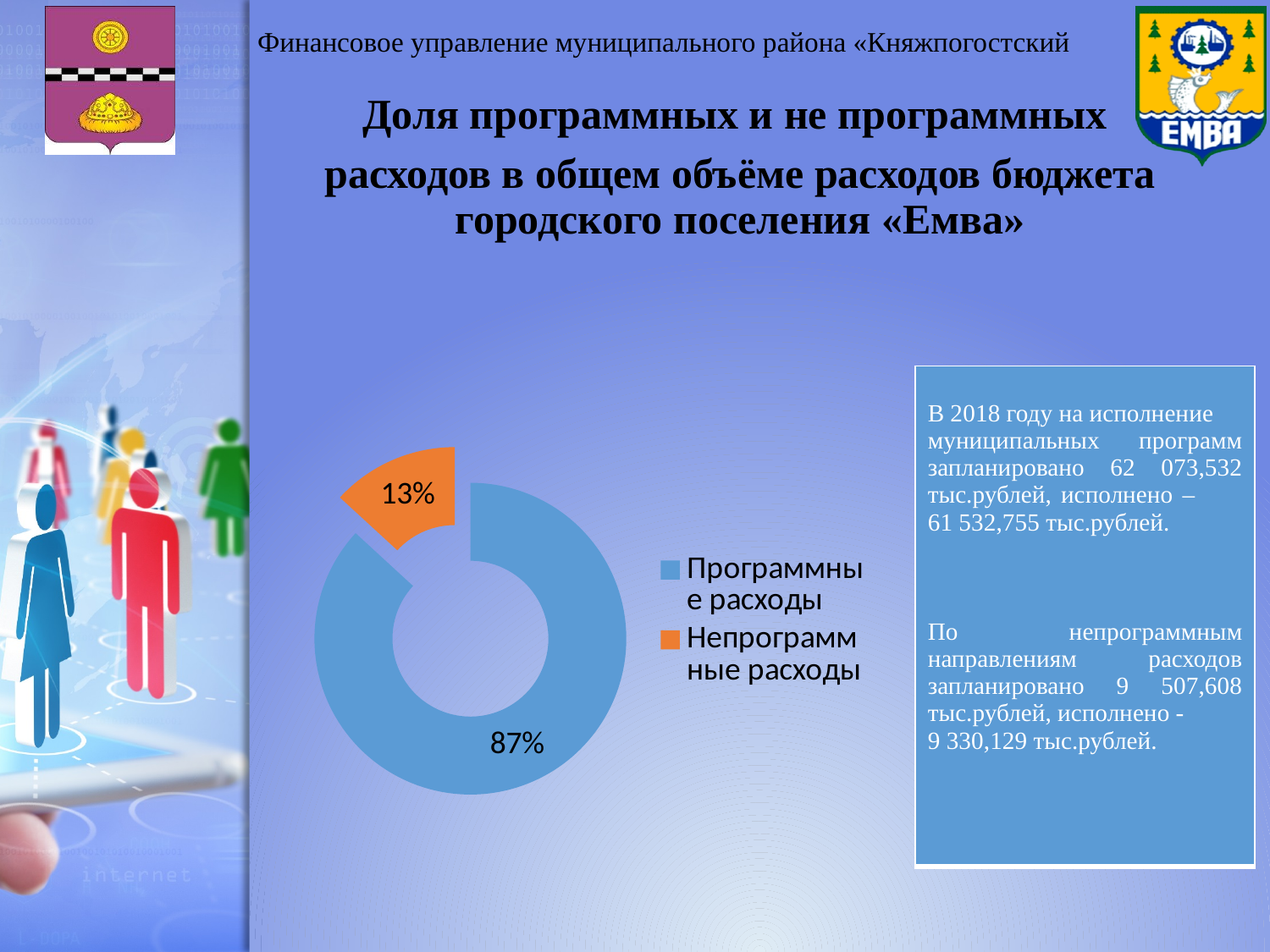
What share of the chart is labelled for Программные расходы? 87% Which category has the smallest share of the chart? Непрограммные расходы What share of the chart is labelled for Непрограммные расходы? 13% Which is larger: the share for Программные расходы or the share for Непрограммные расходы? Программные расходы What kind of chart is shown on the slide? Doughnut (pie) chart Do the two labelled shares on the chart add up to 100%? Yes What colour is the slice for Программные расходы? Blue Which category has the largest share of the chart? Программные расходы What colour is the slice for Непрограммные расходы? Orange What is the difference in percentage points between Программные расходы and Непрограммные расходы? 74 How many entries does the chart legend list? 2 How many categories does the chart show? 2